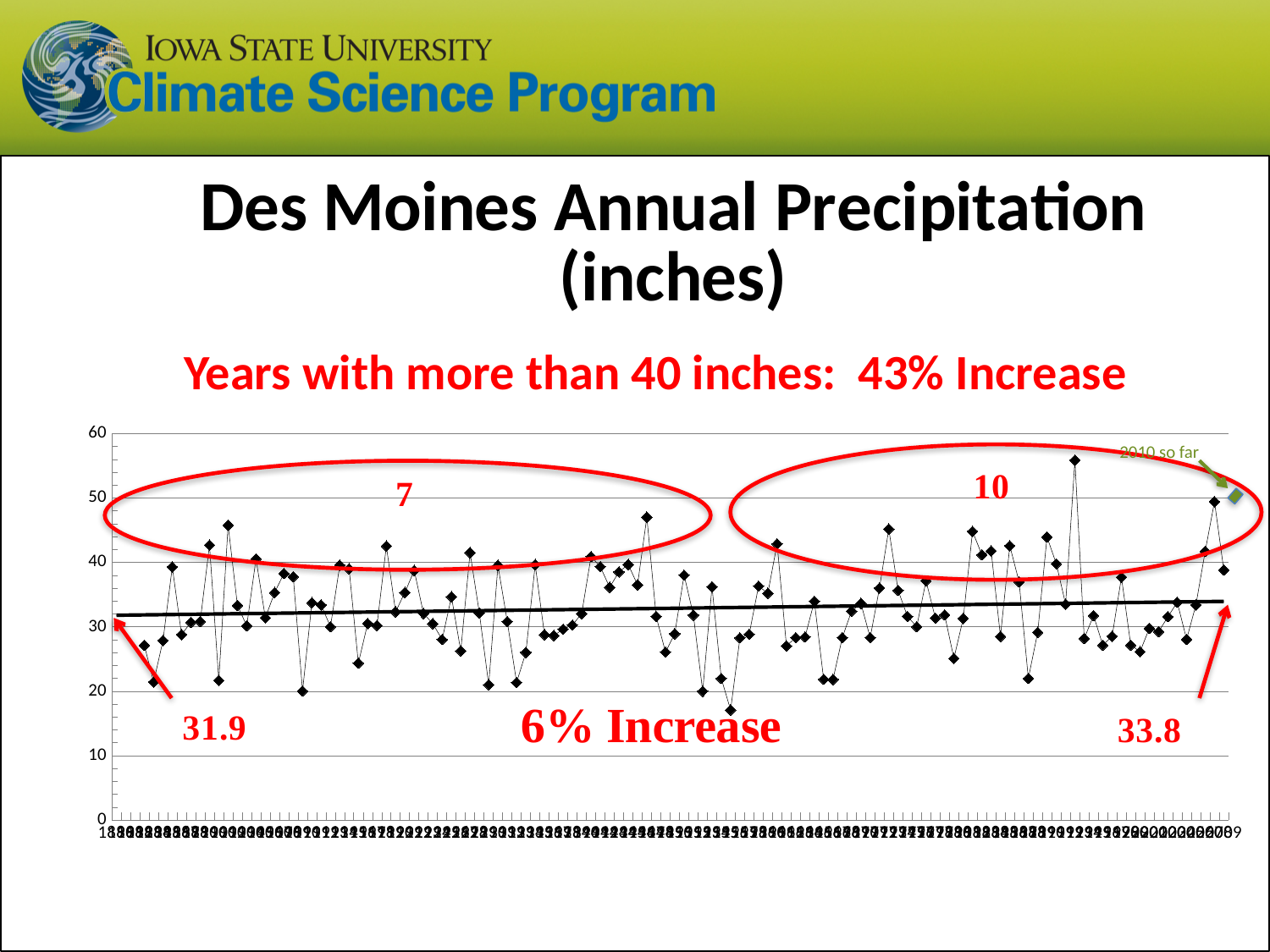
What type of chart is shown on the slide? Line chart What value does the trend line end at on the right side of the chart, as labelled? 33.8 How many years with more than 40 inches are counted in the left red circle? 7 What percentage increase does the trend line annotation state? 6% Increase What value does the trend line start at on the left side of the chart, as labelled? 31.9 What is the difference between the labelled trend-line end value (33.8) and start value (31.9)? 1.9 Is the highest plotted annual precipitation value greater or less than 50? greater Which labelled trend-line value is larger, the starting value or the ending value? The ending value (33.8) How many years with more than 40 inches are counted in the right red circle? 10 Does the trend line rise or fall from left to right across the chart? Rises What is the title of the chart on the slide? Des Moines Annual Precipitation (inches) What is the maximum value shown on the y-axis of the chart? 60